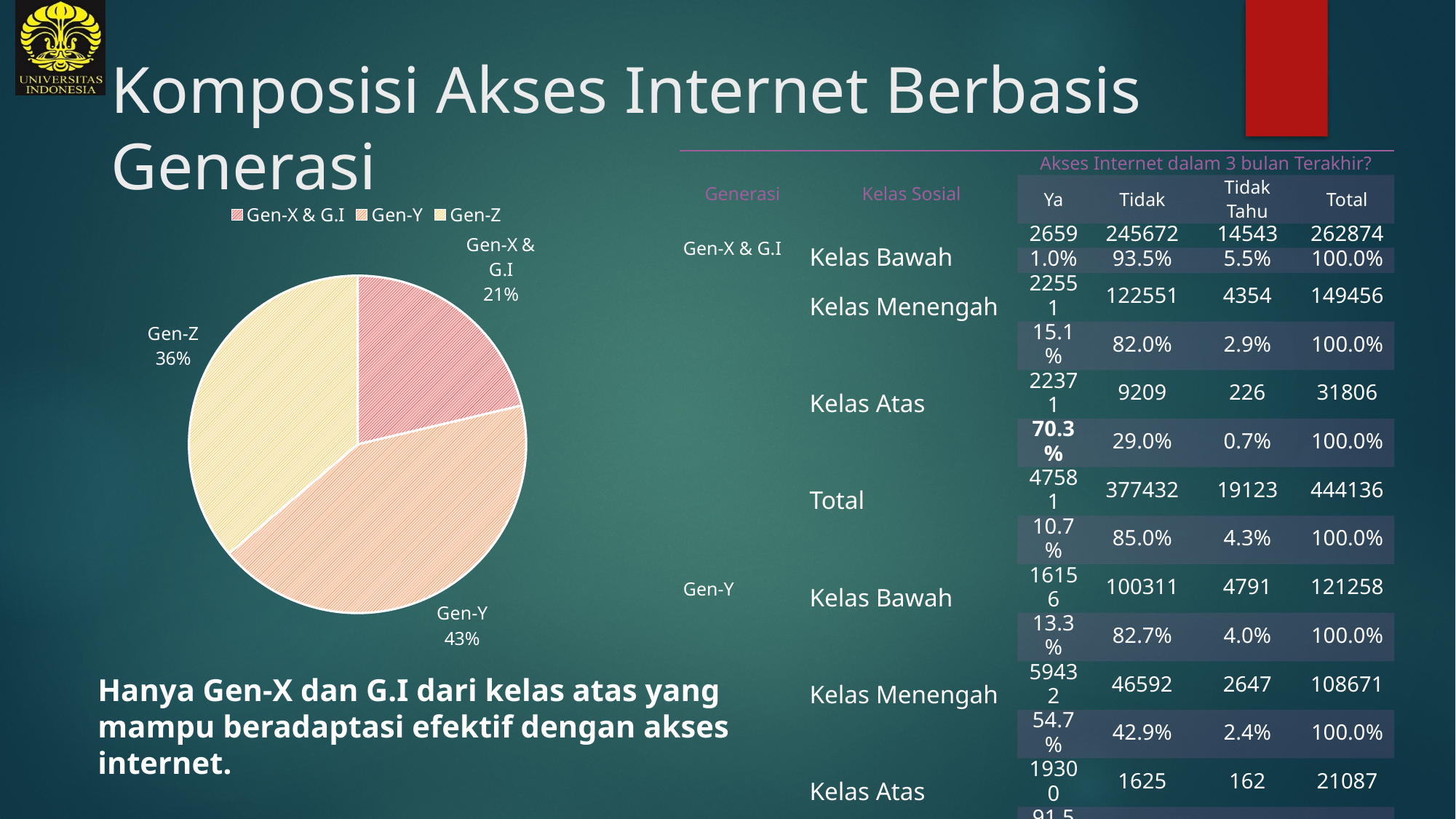
Which slice is larger, Gen-Z or Gen-X & G.I? Gen-Z Which legend entry is shown in yellow in the pie chart? Gen-Z How many entries does the pie chart legend list? 3 What share of the pie does Gen-X & G.I hold? 21% What is the difference in percentage points between the Gen-Y slice and the Gen-X & G.I slice? 22% What share of the pie does Gen-Y hold? 43% Which generation has the largest slice of the pie? Gen-Y What share of the pie does Gen-Z hold? 36% How many slices does the pie chart have? 3 Which generation has the smallest slice of the pie? Gen-X & G.I What kind of chart is shown on the slide? pie chart What is the difference in percentage points between the Gen-Y slice and the Gen-Z slice? 7%